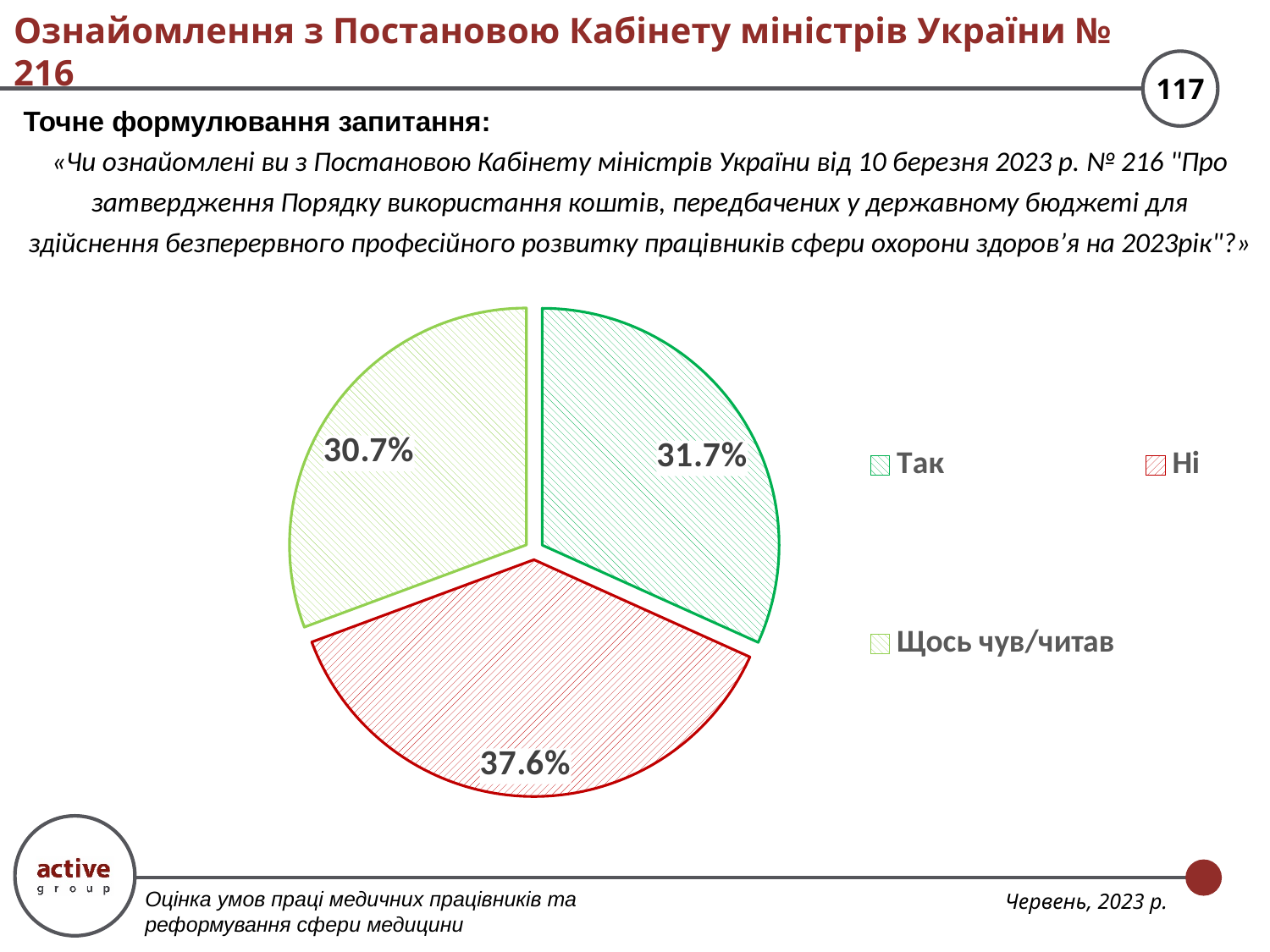
Which legend entry is shown with red hatching? Ні What is the difference in percentage points between the "Ні" and "Так" slices? 5.9 How many slices does the pie chart have? 3 Which answer option has the smallest share of the pie? Щось чув/читав What share of respondents answered "Так"? 31.7% What share of respondents answered "Щось чув/читав"? 30.7% Which is larger: the share for "Ні" or the share for "Щось чув/читав"? Ні How many entries does the legend list? 3 What share of respondents answered "Ні"? 37.6% What type of chart is shown on the slide? pie chart What is the difference in percentage points between the "Так" and "Щось чув/читав" slices? 1.0 Which answer option has the largest share of the pie? Ні